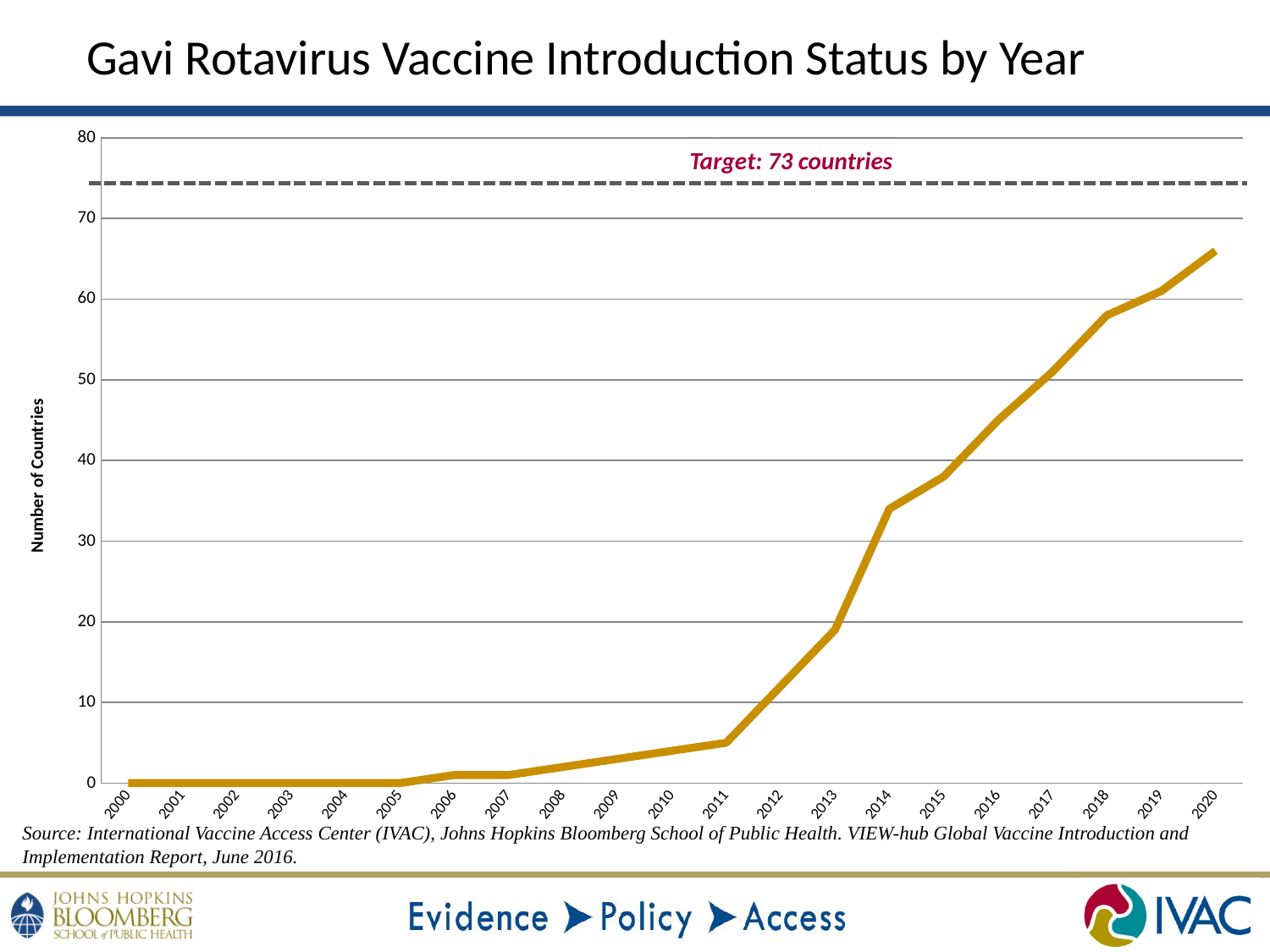
Is the value for 2014 greater or less than 30? greater Do the values generally rise or fall from 2000 to 2020? Rise What kind of chart is shown on the slide? Line chart Which year has the larger value, 2012 or 2018? 2018 What is the number of countries for 2000? 0 How many years are plotted along the x axis? 21 Is the value for 2016 greater or less than 50? less Is the value for 2020 greater or less than 60? greater Which year has the highest number of countries? 2020 What target value is marked by the dashed line on the chart? 73 countries What is the title of the chart? Gavi Rotavirus Vaccine Introduction Status by Year